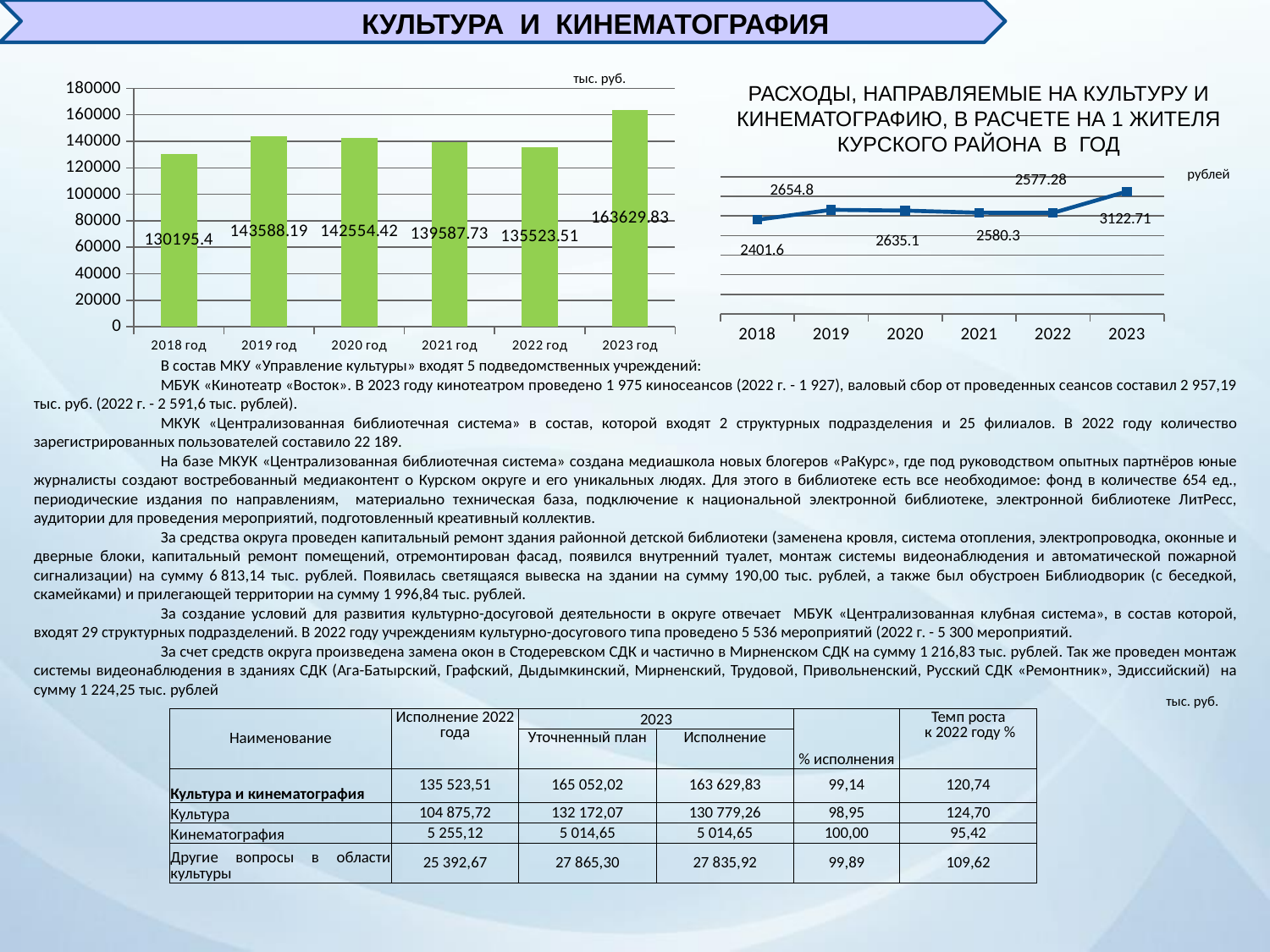
In the bar chart on the left of the slide, which is larger: the value for 2019 год or the value for 2021 год? 2019 год In the bar chart on the left of the slide, what is the value for 2018 год? 130195.4 In the bar chart on the left of the slide, which year has the lowest value? 2018 год In the bar chart on the left of the slide, what is the difference between the values for 2023 год and 2022 год? 28106.32 In the bar chart on the left of the slide, how many years are shown? 6 In the bar chart on the left of the slide, what is the value for 2023 год? 163629.83 What type of chart is the chart on the left of the slide? bar chart In the line chart on the right of the slide (expenses per resident), what is the value for 2018? 2401.6 In the bar chart on the left of the slide, which year has the highest value? 2023 год In the line chart on the right of the slide (expenses per resident), what is the difference between the values for 2023 and 2022? 545.43 In the line chart on the right of the slide (expenses per resident), which year has the lowest value? 2018 In the line chart on the right of the slide (expenses per resident), what is the value for 2023? 3122.71